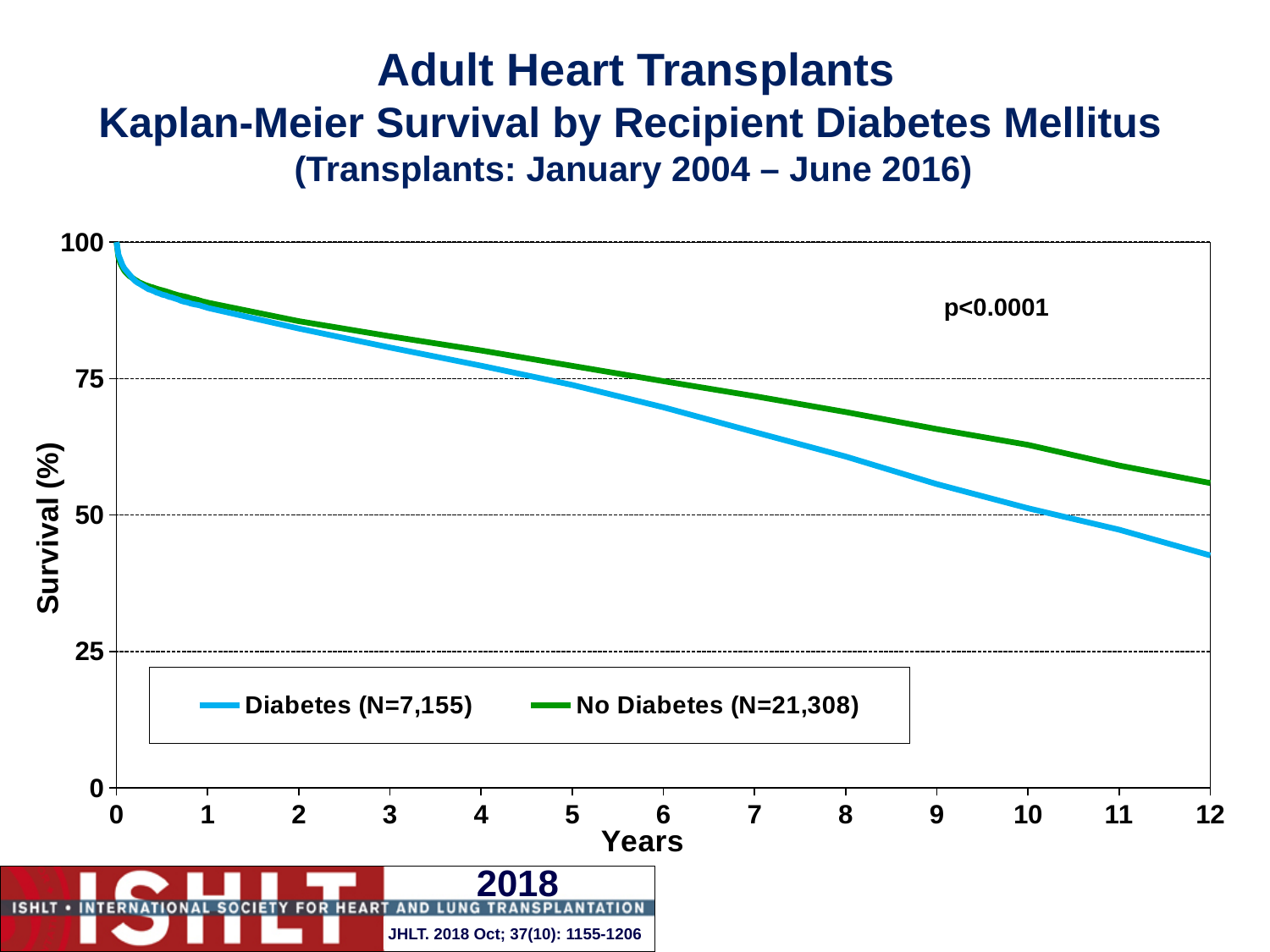
What is the sample size (N) for the Diabetes group shown in the legend? 7,155 Is the survival for the Diabetes group at 12 years greater or less than 50? less What kind of chart is shown on the slide? Line chart What p-value is shown on the chart? p<0.0001 Is the survival for the No Diabetes group at 8 years greater or less than 75? less What is the survival percentage for both groups at year 0? 100 Is the survival for the Diabetes group at 8 years greater or less than 50? greater How many series does the legend list? 2 Do the survival curves rise or fall as years increase? Fall At 12 years, which group has higher survival: Diabetes or No Diabetes? No Diabetes